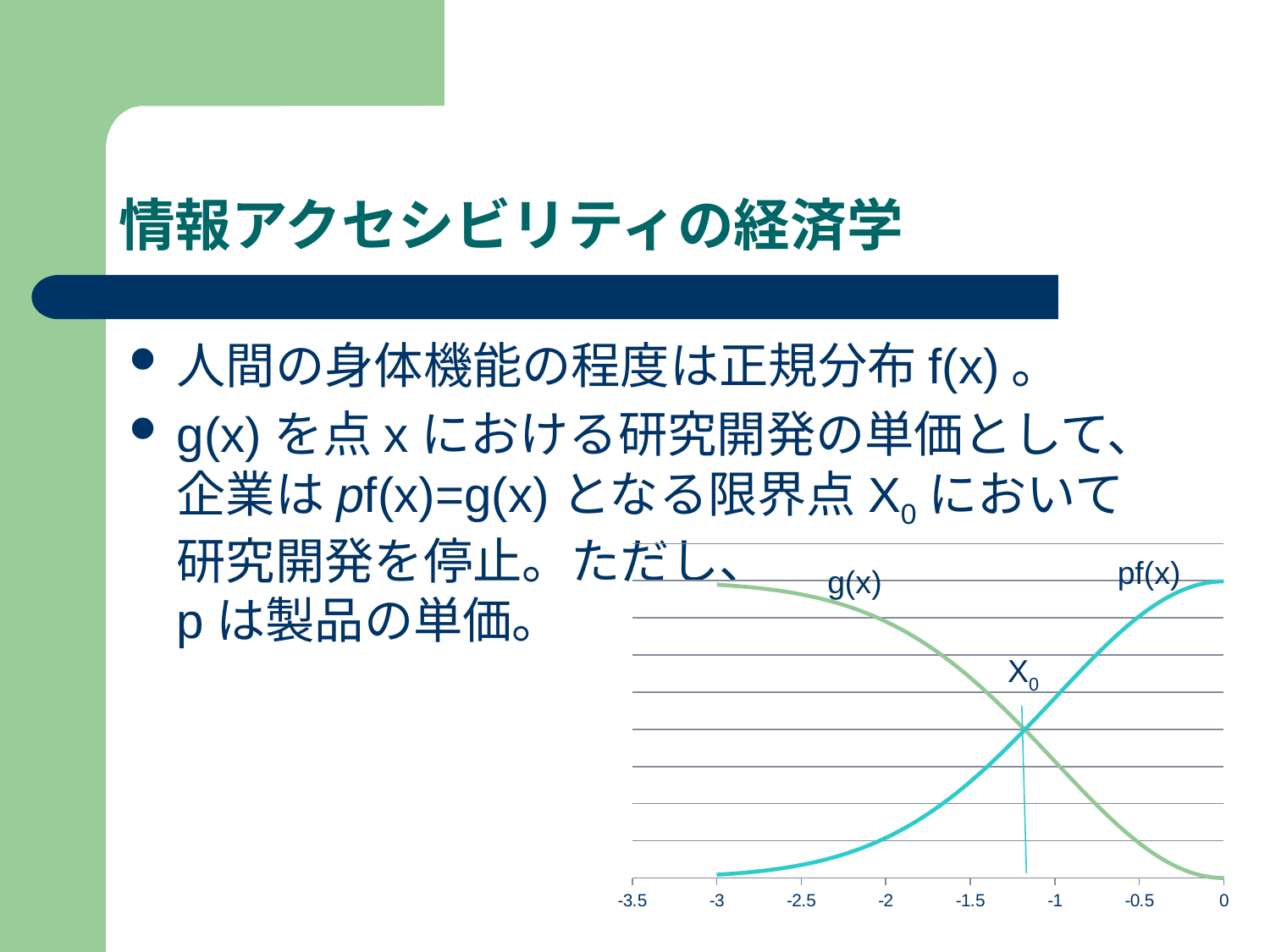
At x = -0.5, which curve is higher, g(x) or pf(x)? pf(x) What is the lowest tick label on the x axis? -3.5 At x = -2, which curve is higher, g(x) or pf(x)? g(x) What label marks the point where the two curves intersect? X0 Is the intersection point X0 located at an x value greater or less than -1? less How many tick labels are shown on the x axis? 8 What kind of chart is shown on the slide? line chart How many curves are plotted on the chart? 2 What are the labels of the two curves on the chart? g(x) and pf(x) Does the g(x) curve rise or fall as x increases from -3 to 0? fall Is the intersection point X0 located at an x value greater or less than -1.5? greater Does the pf(x) curve rise or fall as x increases from -3 to 0? rise